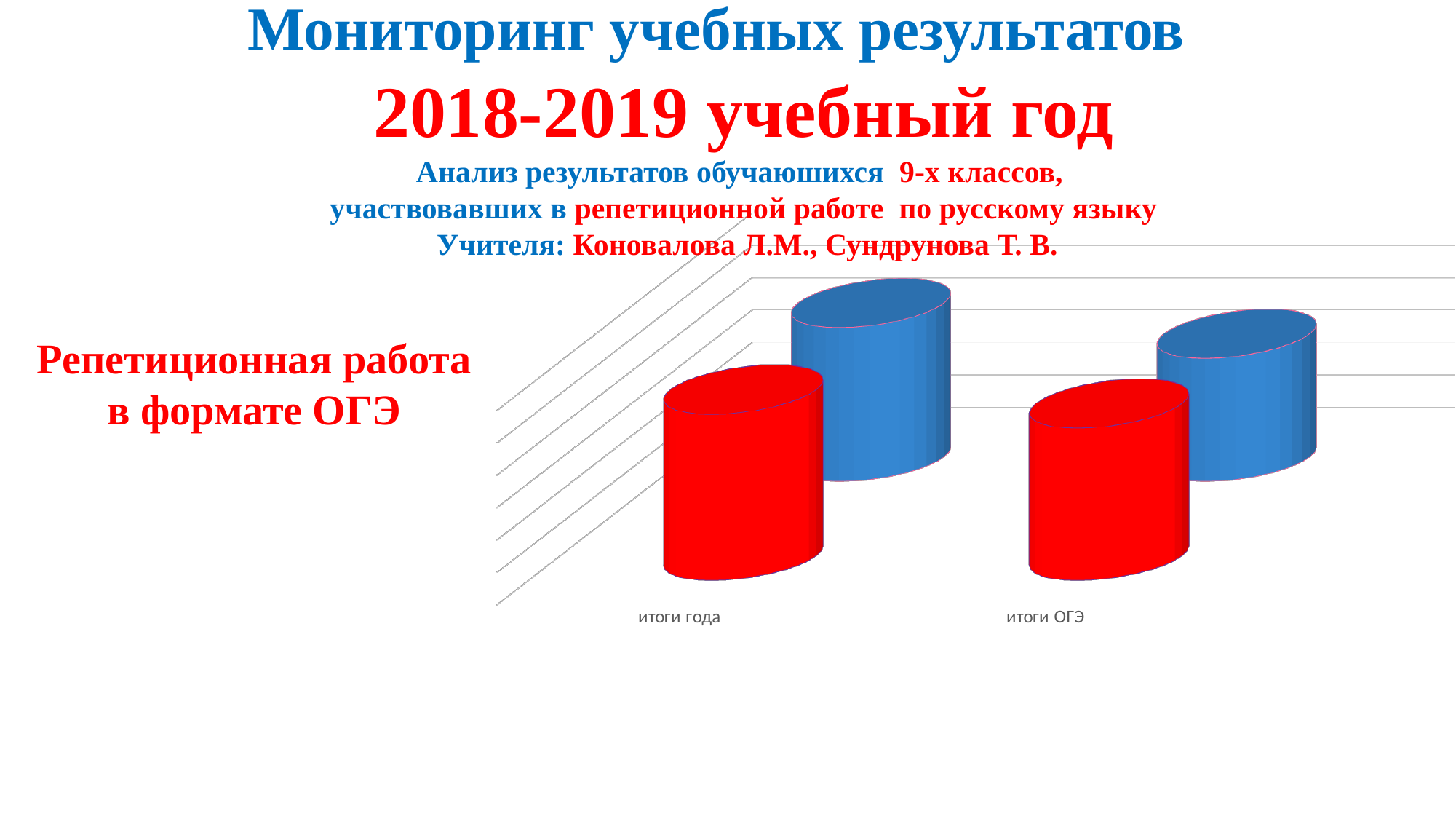
In which category is the red bar lowest? итоги ОГЭ How many categories are shown on the x axis of the chart? 2 In which category is the blue bar highest? итоги года Does the red series rise or fall from "итоги года" to "итоги ОГЭ"? fall What are the two category labels on the x axis of the chart? итоги года, итоги ОГЭ Does the blue series rise or fall from "итоги года" to "итоги ОГЭ"? fall For the category "итоги года", which bar is taller, the red one or the blue one? red What kind of chart is shown on the slide? bar chart What two colours are used for the bars in the chart? red and blue For the category "итоги ОГЭ", which bar is taller, the red one or the blue one? red